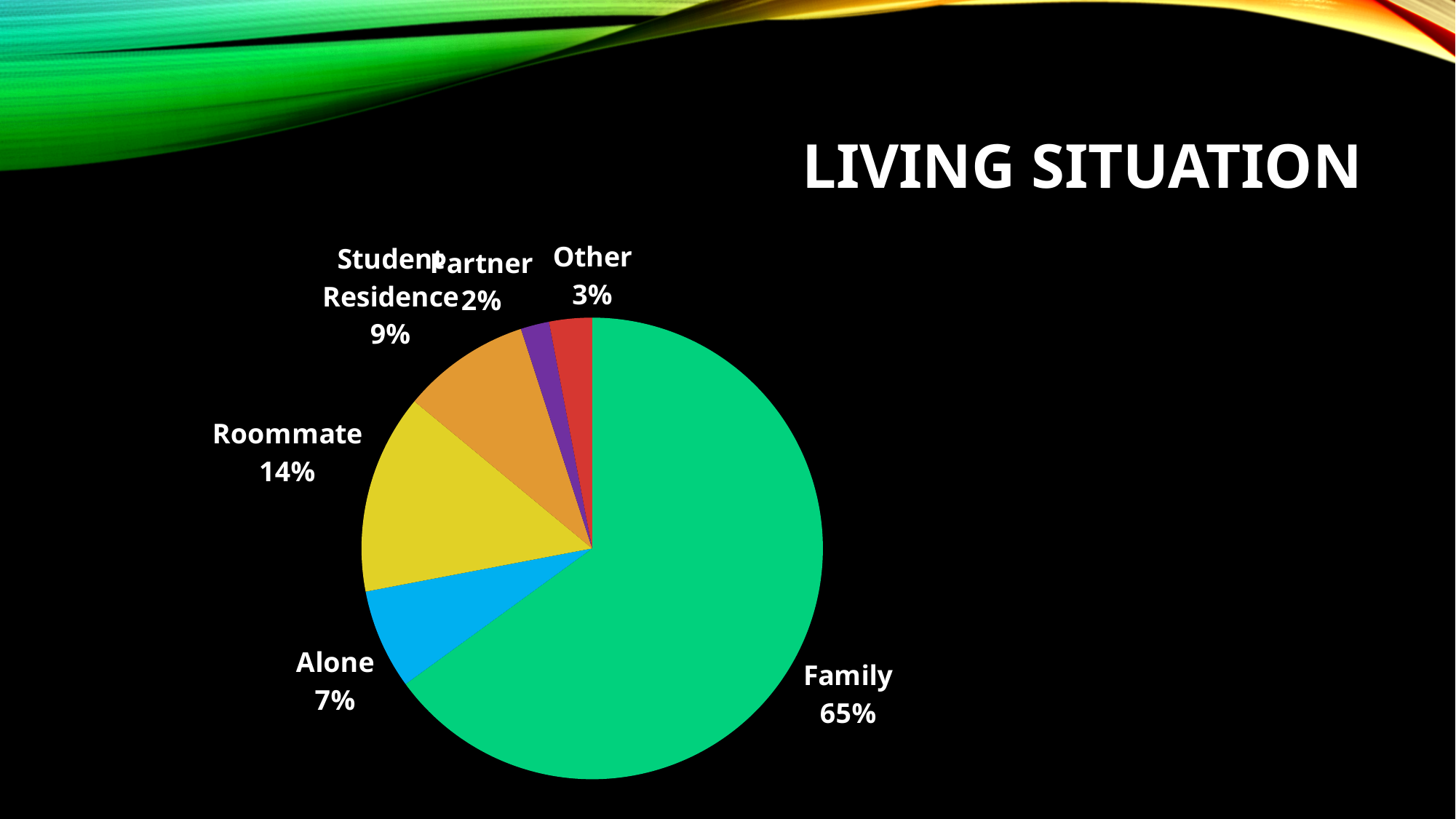
What is the title of the slide? Living Situation Which is larger, Student Residence or Other? Student Residence Which category has the largest slice? Family What kind of chart is shown on the slide? Pie chart What is the value for Student Residence? 9% What is the value for Alone? 7% What share of the pie does Family account for? 65% What is the value for Roommate? 14% What is the difference between Roommate and Alone? 7% Which category has the smallest slice? Partner What is the value for Partner? 2% How many categories are shown in the pie chart? 6